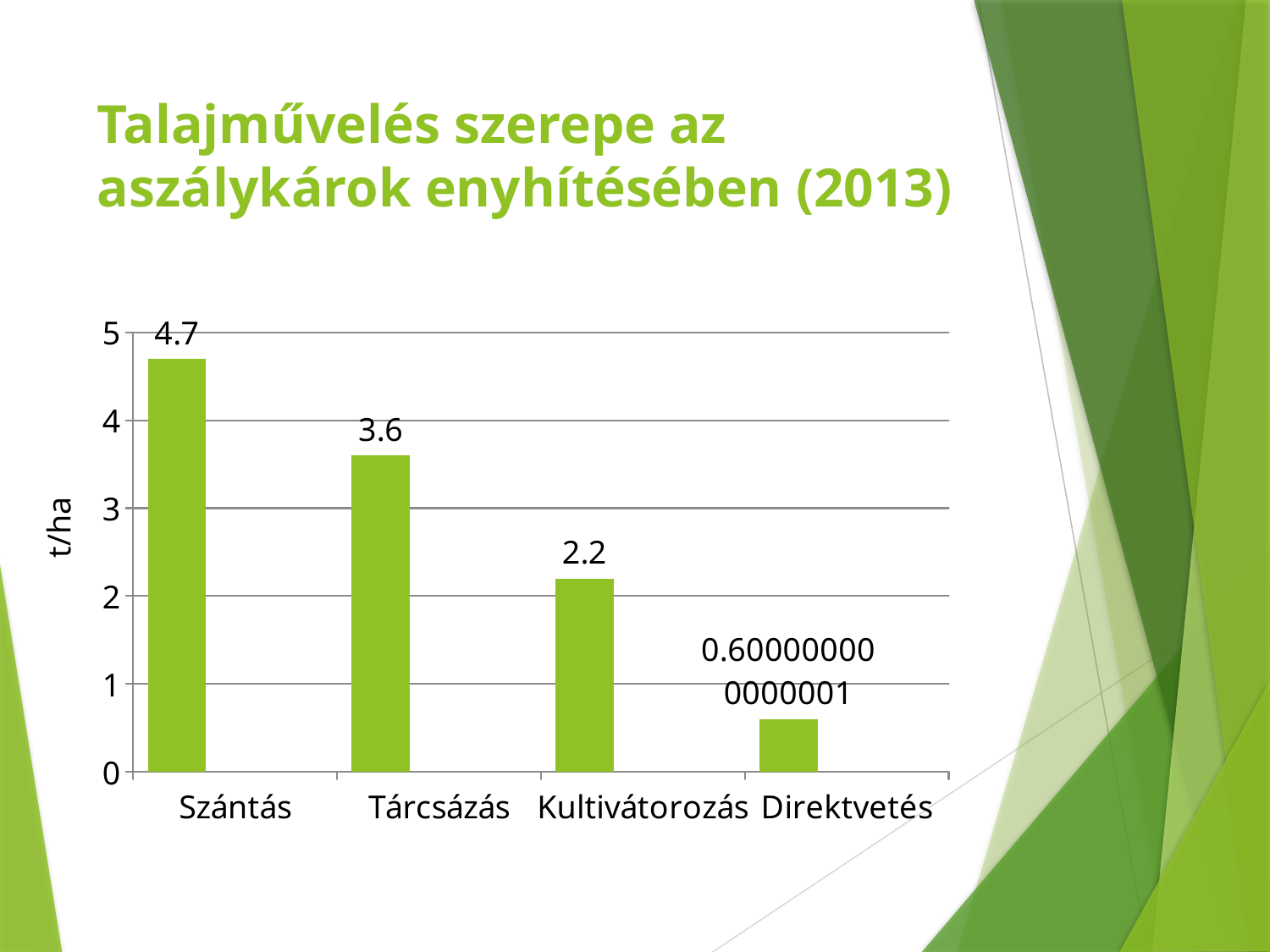
What is the value for Tárcsázás? 3.6 Which category has the highest value? Szántás What is the difference between the values for Szántás and Tárcsázás? 1.1 What is the difference between the values for Tárcsázás and Kultivátorozás? 1.4 How many categories are shown on the x axis? 4 What kind of chart is shown on the slide? bar chart Is the value for Direktvetés greater or less than 1? less What is the value for Szántás? 4.7 Which category has the lowest value? Direktvetés What is the value for Kultivátorozás? 2.2 Which is larger, the value for Kultivátorozás or the value for Direktvetés? Kultivátorozás What is the label of the vertical axis? t/ha